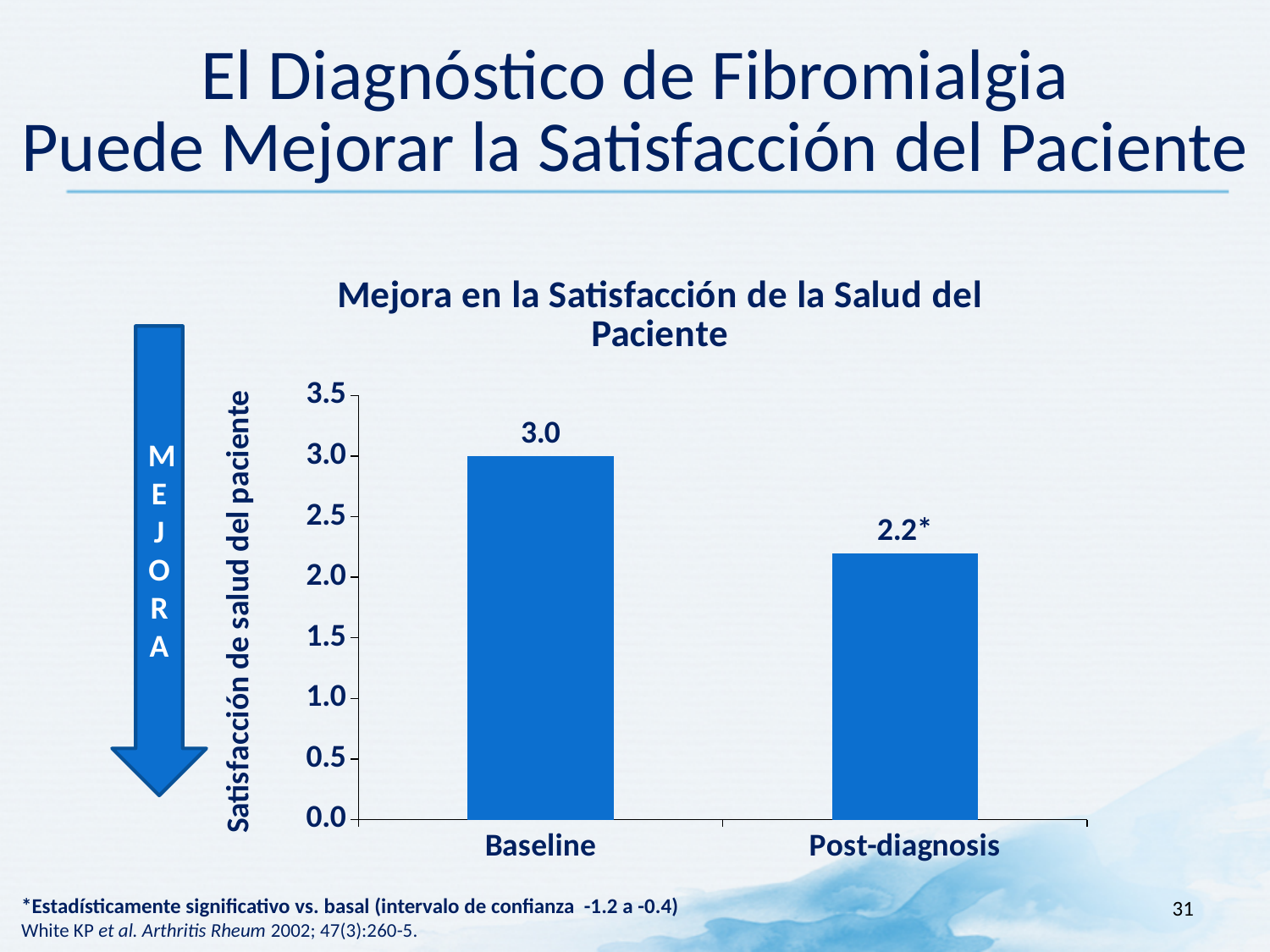
Is the value for Post-diagnosis greater or less than 2.5? less How many categories are shown on the x axis? 2 What is the difference between the Baseline and Post-diagnosis values? 0.8 What is the label of the y axis? Satisfacción de salud del paciente What is the title of the chart? Mejora en la Satisfacción de la Salud del Paciente Which is larger, the value for Baseline or the value for Post-diagnosis? Baseline Which category has the highest value? Baseline What is the value for Baseline? 3.0 What is the value for Post-diagnosis? 2.2 What kind of chart is shown on the slide? bar chart Which category has the lowest value? Post-diagnosis Do the values rise or fall from Baseline to Post-diagnosis? fall